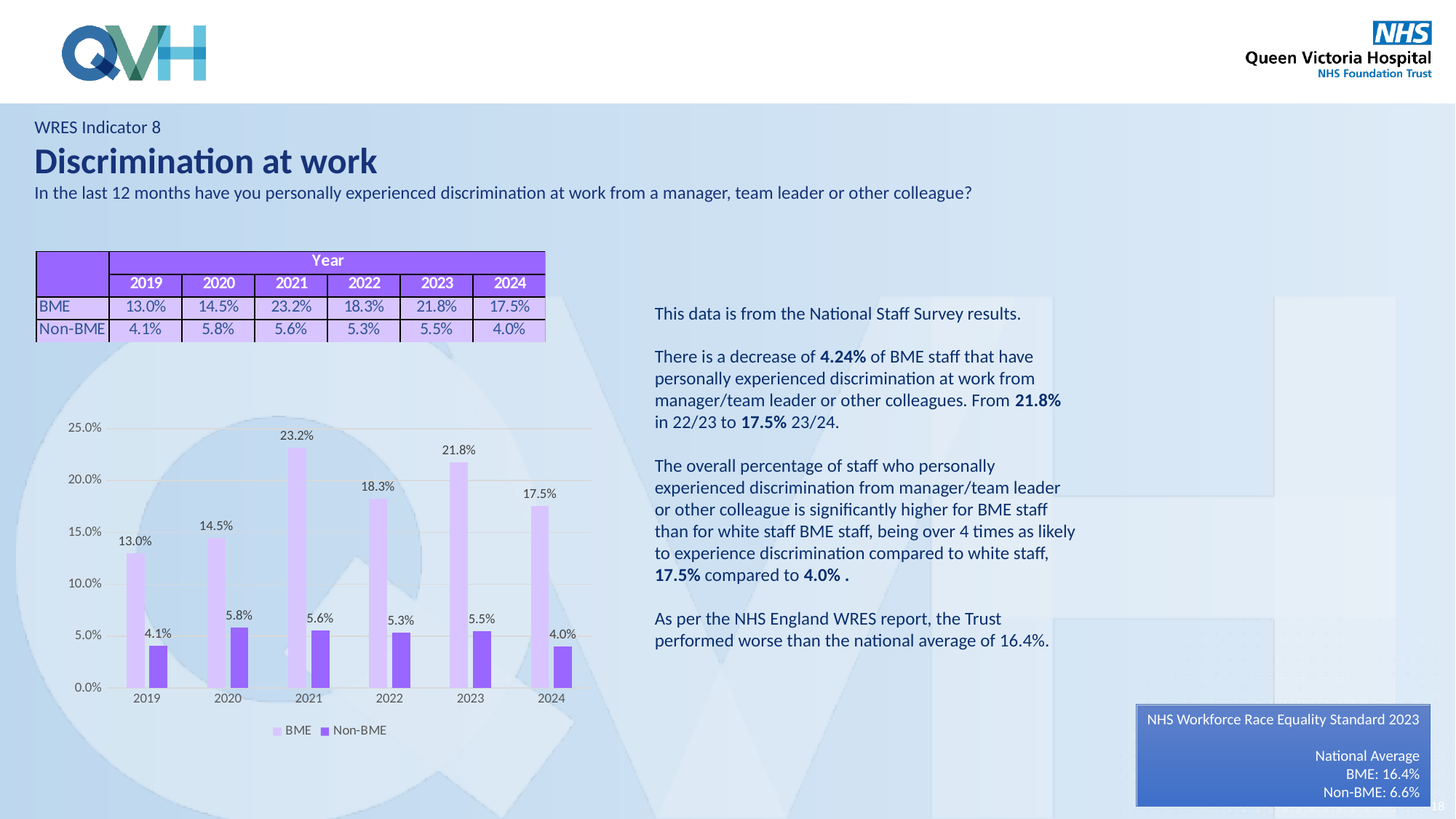
What is the BME value for 2019? 13.0% How many series does the chart legend list? 2 How many years are shown on the x axis of the chart? 6 Which year has the highest BME value? 2021 What is the difference between the BME and Non-BME values in 2023? 16.3% What kind of chart is shown on the slide? bar chart What is the BME value for 2021? 23.2% Which is larger, the BME value for 2022 or the BME value for 2023? 2023 Which year has the lowest Non-BME value? 2024 Did the BME value rise or fall from 2023 to 2024? fall Is the BME value for 2024 greater or less than 20.0%? less What is the Non-BME value for 2024? 4.0%